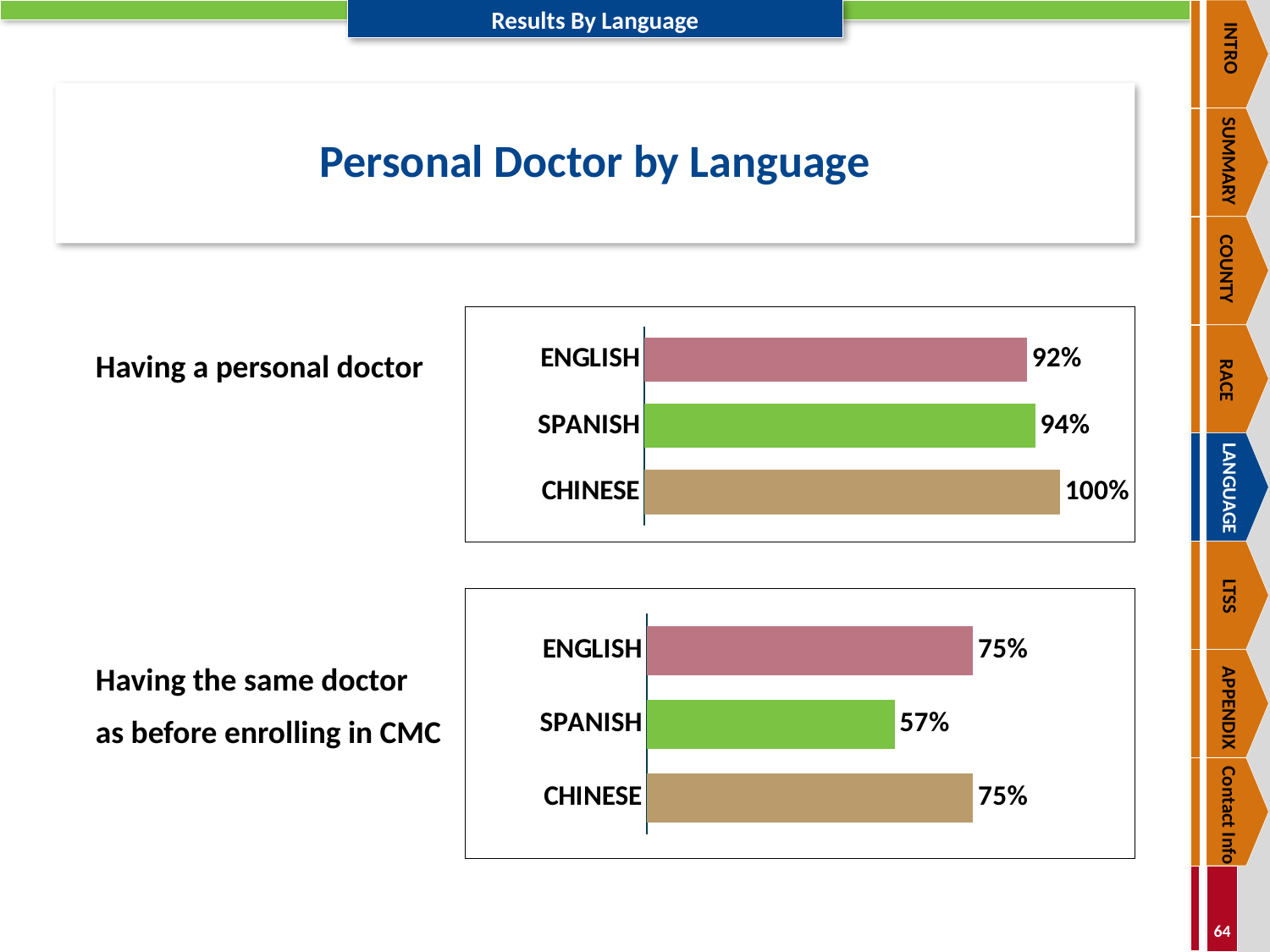
In the 'Having a personal doctor' chart, which language has the lowest value? ENGLISH In the 'Having a personal doctor' chart, what is the value for SPANISH? 94% How many language categories are shown in the 'Having the same doctor as before enrolling in CMC' chart? 3 In the 'Having the same doctor as before enrolling in CMC' chart, what is the value for ENGLISH? 75% In the 'Having a personal doctor' chart, what is the difference between the CHINESE and ENGLISH values? 8% In the 'Having the same doctor as before enrolling in CMC' chart, what is the value for SPANISH? 57% In the 'Having a personal doctor' chart, which language has the highest value? CHINESE In the 'Having the same doctor as before enrolling in CMC' chart, what is the difference between the ENGLISH and SPANISH values? 18% In the 'Having a personal doctor' chart, which is larger, the value for SPANISH or the value for ENGLISH? SPANISH In the 'Having a personal doctor' chart, what is the value for CHINESE? 100% What type of chart is the 'Having a personal doctor' chart? Bar chart In the 'Having the same doctor as before enrolling in CMC' chart, which language has the lowest value? SPANISH